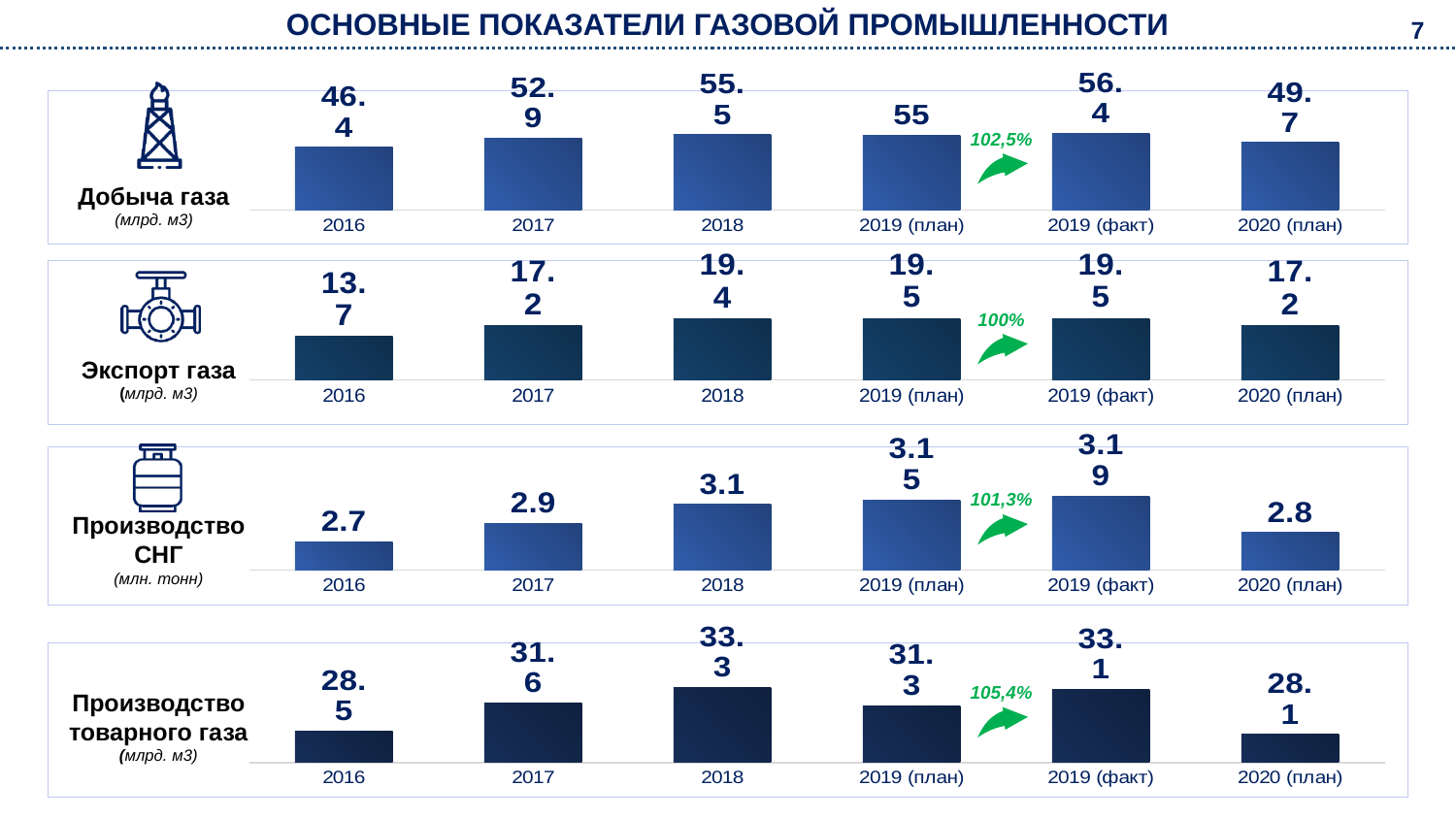
In the Экспорт газа chart, what is the difference between the 2017 and 2016 values? 3.5 In the Производство товарного газа chart, which is larger: the value for 2018 or the value for 2019 (факт)? 2018 How many categories are shown in the Добыча газа chart? 6 In the Производство СНГ chart, what is the value for 2020 (план)? 2.8 What kind of chart is the Экспорт газа chart? bar chart In the Экспорт газа chart, what is the value for 2018? 19.4 In the Добыча газа chart, which category has the lowest value? 2016 In the Производство товарного газа chart, what is the value for 2016? 28.5 In the Добыча газа chart, what is the value for 2019 (факт)? 56.4 In the Производство товарного газа chart, what is the difference between the 2018 and 2020 (план) values? 5.2 In the Производство СНГ chart, which category has the highest value? 2019 (факт) In the Добыча газа chart, what percentage is shown next to the green arrow between 2019 (план) and 2019 (факт)? 102,5%